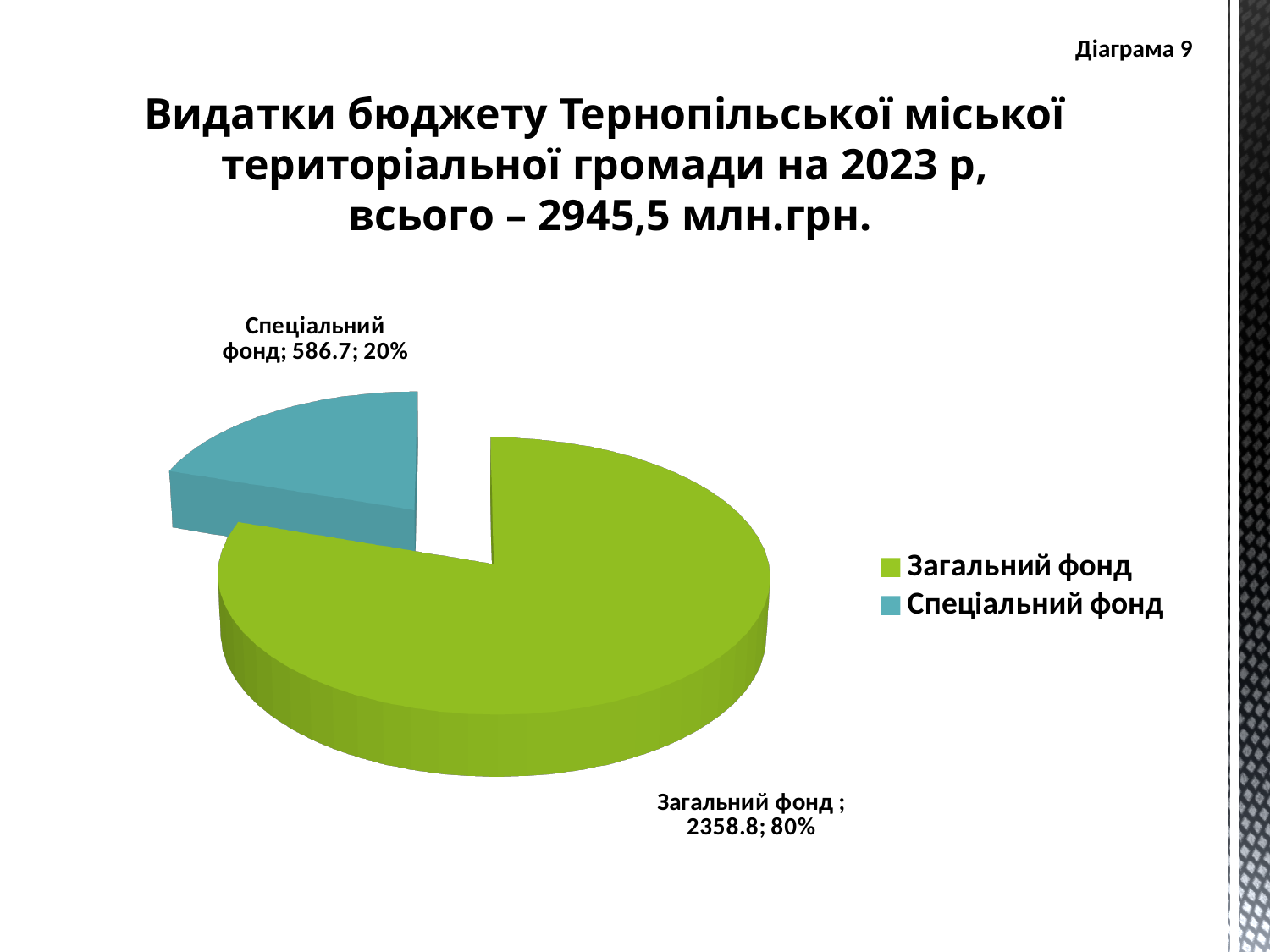
Which is larger, Загальний фонд or Спеціальний фонд? Загальний фонд What is the difference between the values for Загальний фонд and Спеціальний фонд? 1772.1 What colour is the slice for Спеціальний фонд? Blue What kind of chart is shown on the slide? Pie chart How many slices does the pie chart have? 2 What share of the pie does Спеціальний фонд represent? 20% Which category has the largest slice? Загальний фонд What is the value for Спеціальний фонд? 586.7 What share of the pie does Загальний фонд represent? 80% How many entries does the legend list? 2 Which category has the smallest slice? Спеціальний фонд What is the value for Загальний фонд? 2358.8